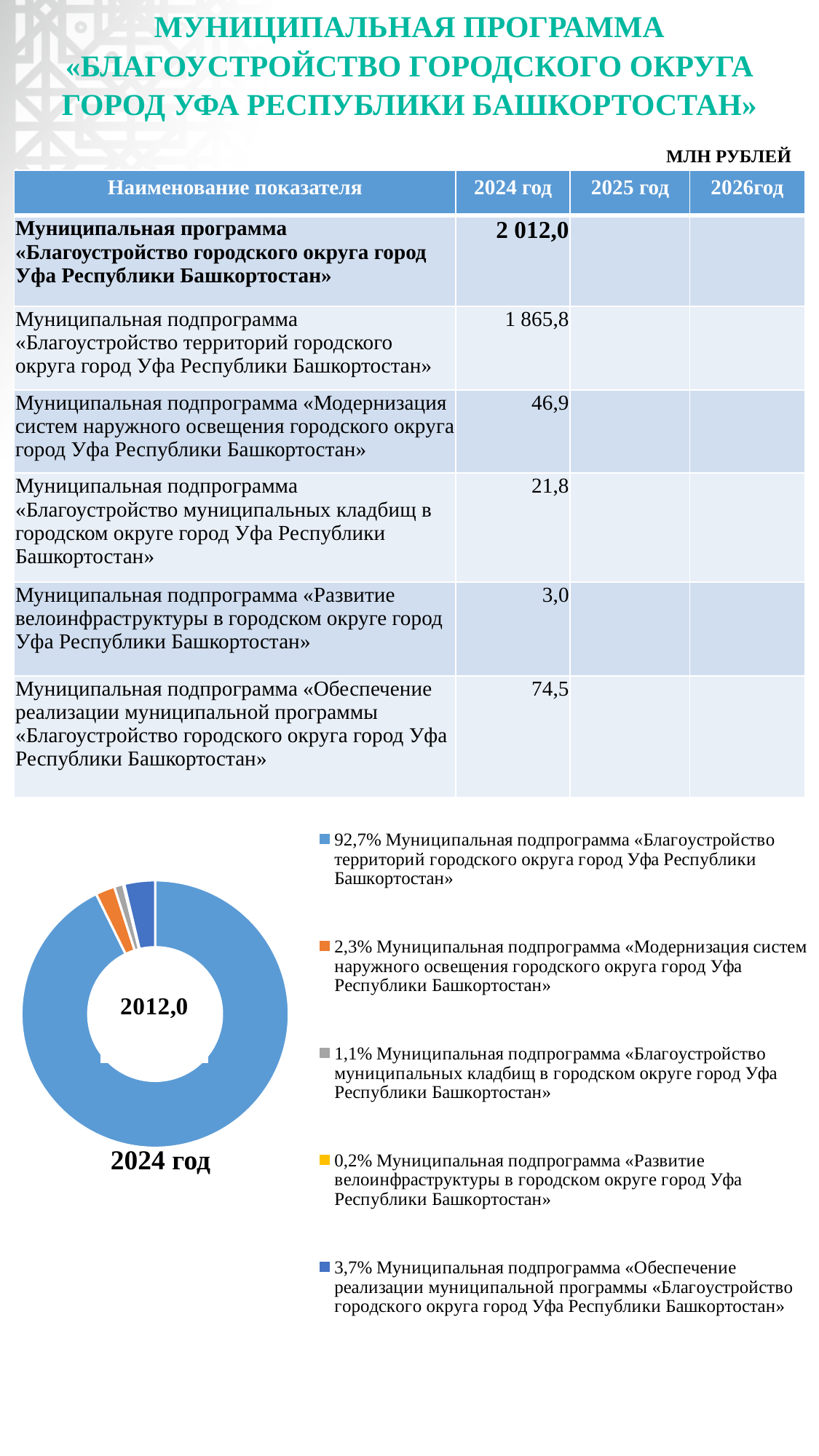
Which slice of the doughnut chart is the smallest? Муниципальная подпрограмма «Развитие велоинфраструктуры в городском округе город Уфа Республики Башкортостан» How many slices does the doughnut chart have? 5 What share of the doughnut chart does the subprogram «Обеспечение реализации муниципальной программы «Благоустройство городского округа город Уфа Республики Башкортостан» have? 3,7% How many entries does the legend of the doughnut chart list? 5 What share of the doughnut chart does the subprogram «Благоустройство территорий городского округа город Уфа Республики Башкортостан» have? 92,7% What share of the doughnut chart does the subprogram «Развитие велоинфраструктуры в городском округе город Уфа Республики Башкортостан» have? 0,2% What kind of chart is shown at the bottom of the slide? Doughnut (pie) chart What value is printed in the centre of the doughnut chart? 2012,0 Which has a larger share in the doughnut chart: the subprogram «Модернизация систем наружного освещения...» or the subprogram «Обеспечение реализации муниципальной программы...»? Муниципальная подпрограмма «Обеспечение реализации муниципальной программы «Благоустройство городского округа город Уфа Республики Башкортостан» Which slice of the doughnut chart is the largest? Муниципальная подпрограмма «Благоустройство территорий городского округа город Уфа Республики Башкортостан»